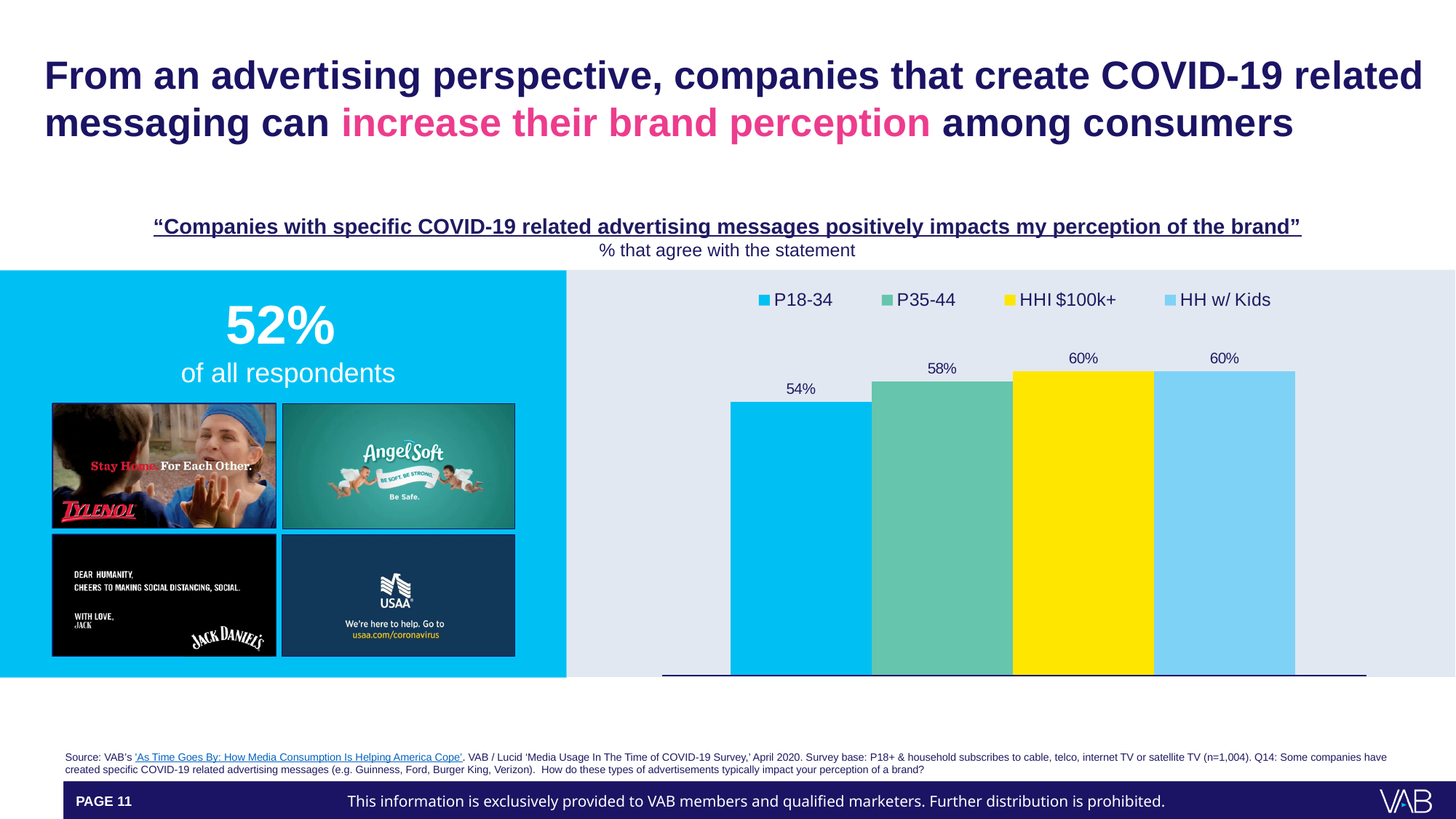
How many series does the legend of the bar chart list? 4 What is the value shown for HHI $100k+ in the bar chart? 60% What is the value shown for P35-44 in the bar chart? 58% Which is larger in the bar chart, the value for HH w/ Kids or the value for P35-44? HH w/ Kids What is the value shown for HH w/ Kids in the bar chart? 60% Which group in the bar chart has the lowest percentage agreeing with the statement? P18-34 What is the difference between the HHI $100k+ value and the P18-34 value in the bar chart? 6% What is the difference between the P35-44 value and the P18-34 value in the bar chart? 4% What percentage of P18-34 respondents agree that companies with specific COVID-19 related advertising messages positively impact their perception of the brand? 54% Which is larger in the bar chart, the value for P35-44 or the value for P18-34? P35-44 What percentage of all respondents agree with the statement, as shown in the blue panel on the left? 52% What kind of chart is shown on the right side of the slide? Bar chart